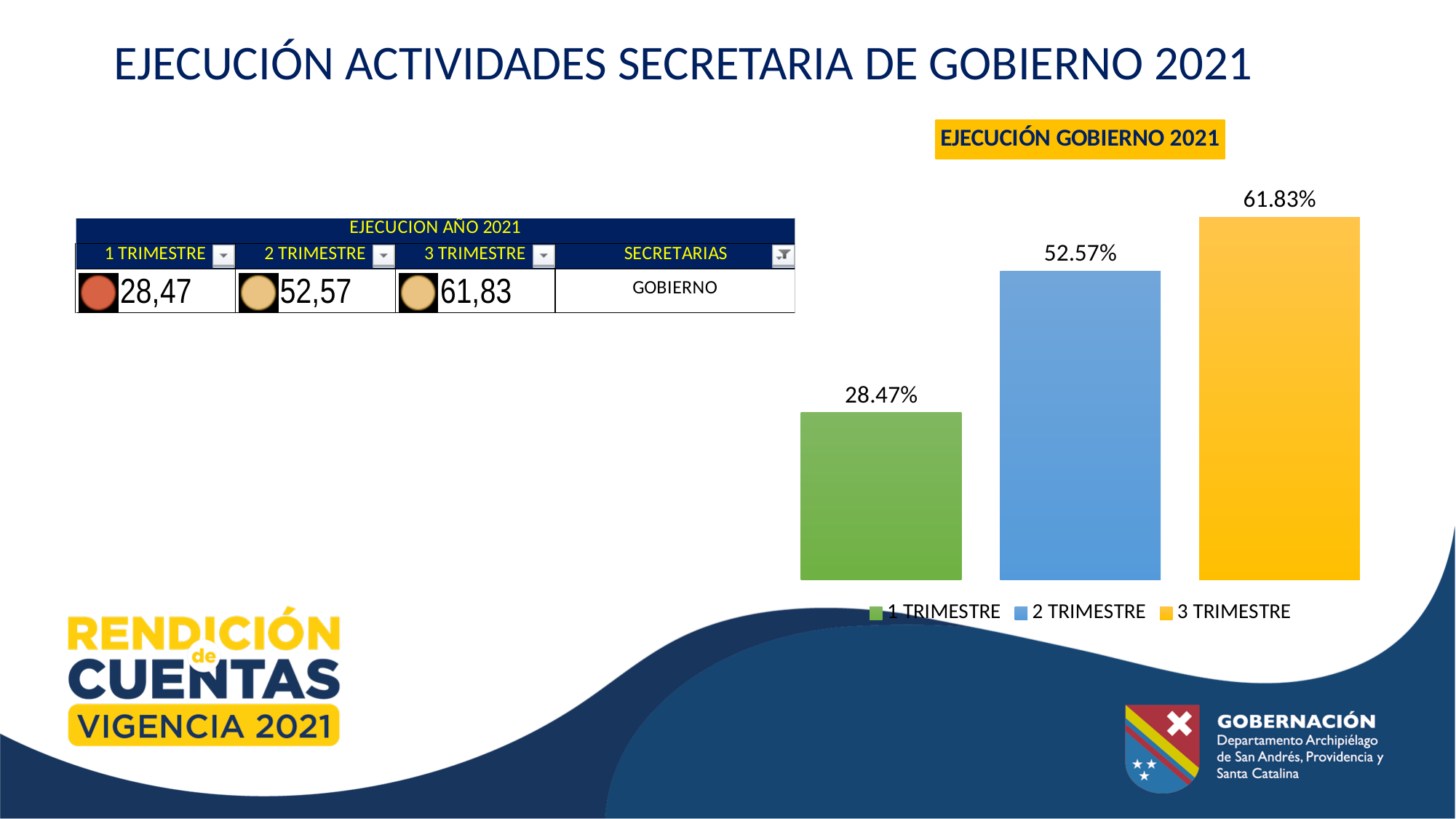
What is the value for 2 TRIMESTRE in the EJECUCIÓN GOBIERNO 2021 chart? 52.57% Which is larger in the EJECUCIÓN GOBIERNO 2021 chart, 1 TRIMESTRE or 2 TRIMESTRE? 2 TRIMESTRE What is the value for 1 TRIMESTRE in the EJECUCIÓN GOBIERNO 2021 chart? 28.47% Which trimester has the highest value in the EJECUCIÓN GOBIERNO 2021 chart? 3 TRIMESTRE Which trimester has the lowest value in the EJECUCIÓN GOBIERNO 2021 chart? 1 TRIMESTRE What is the difference between the 2 TRIMESTRE and 1 TRIMESTRE values in the EJECUCIÓN GOBIERNO 2021 chart? 24.10% What is the difference between the 3 TRIMESTRE and 2 TRIMESTRE values in the EJECUCIÓN GOBIERNO 2021 chart? 9.26% How many series does the legend of the EJECUCIÓN GOBIERNO 2021 chart list? 3 What kind of chart is the EJECUCIÓN GOBIERNO 2021 chart? Bar chart How many bars are shown in the EJECUCIÓN GOBIERNO 2021 chart? 3 What is the value for 3 TRIMESTRE in the EJECUCIÓN GOBIERNO 2021 chart? 61.83% Do the values rise or fall from 1 TRIMESTRE to 3 TRIMESTRE in the EJECUCIÓN GOBIERNO 2021 chart? Rise